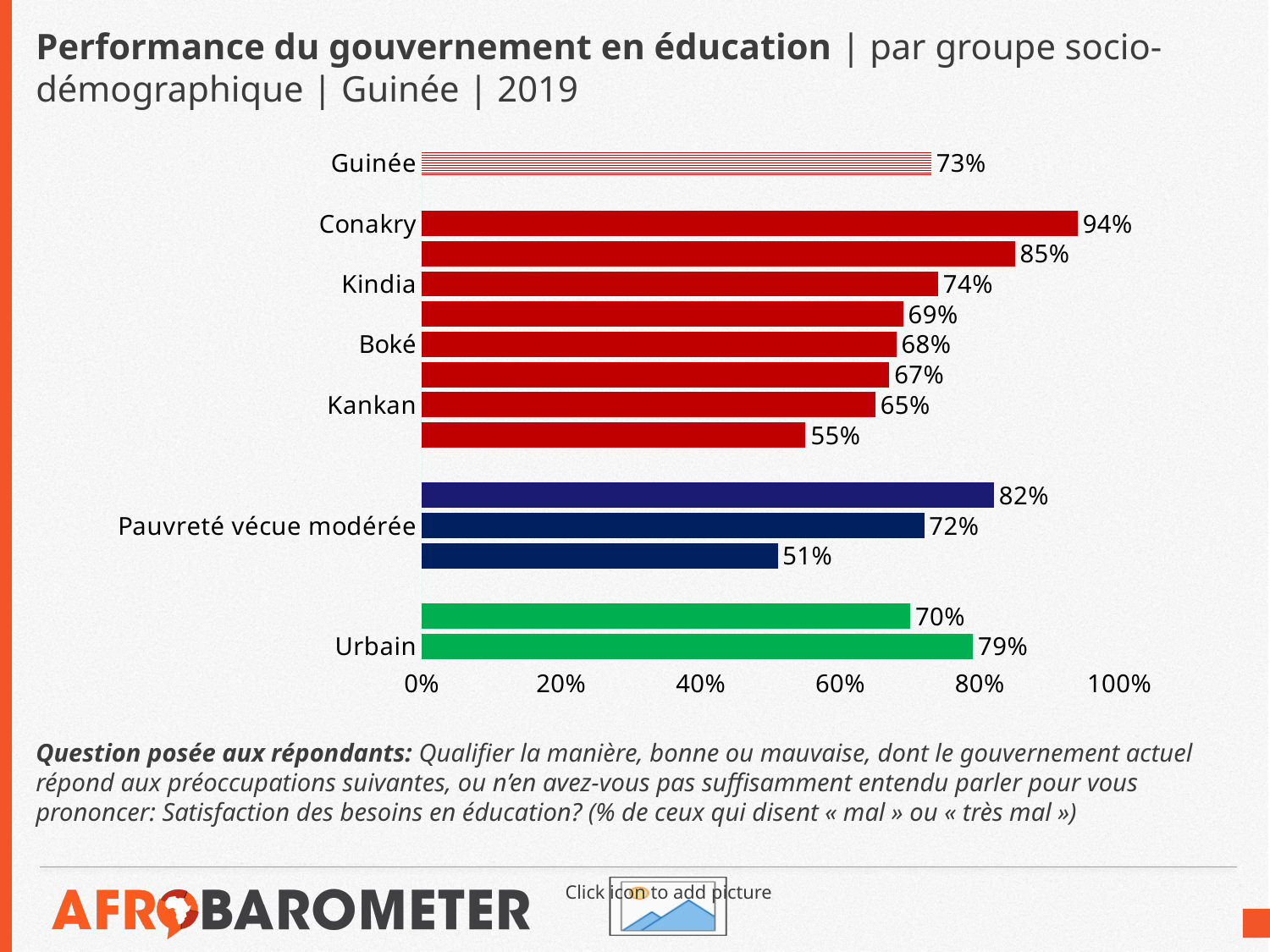
What is the value for Guinée? 73% What is the difference between the values for Conakry and Kankan? 29% What is the value for Pauvreté vécue modérée? 72% Which labelled category has the highest value? Conakry What is the value for Conakry? 94% What is the lowest value shown on the chart? 51% What is the value for Boké? 68% What is the value for Urbain? 79% Which is larger, the value for Urbain or the value for Kindia? Urbain What is the value for Kankan? 65% What is the value for Kindia? 74% What type of chart is shown on the slide? bar chart